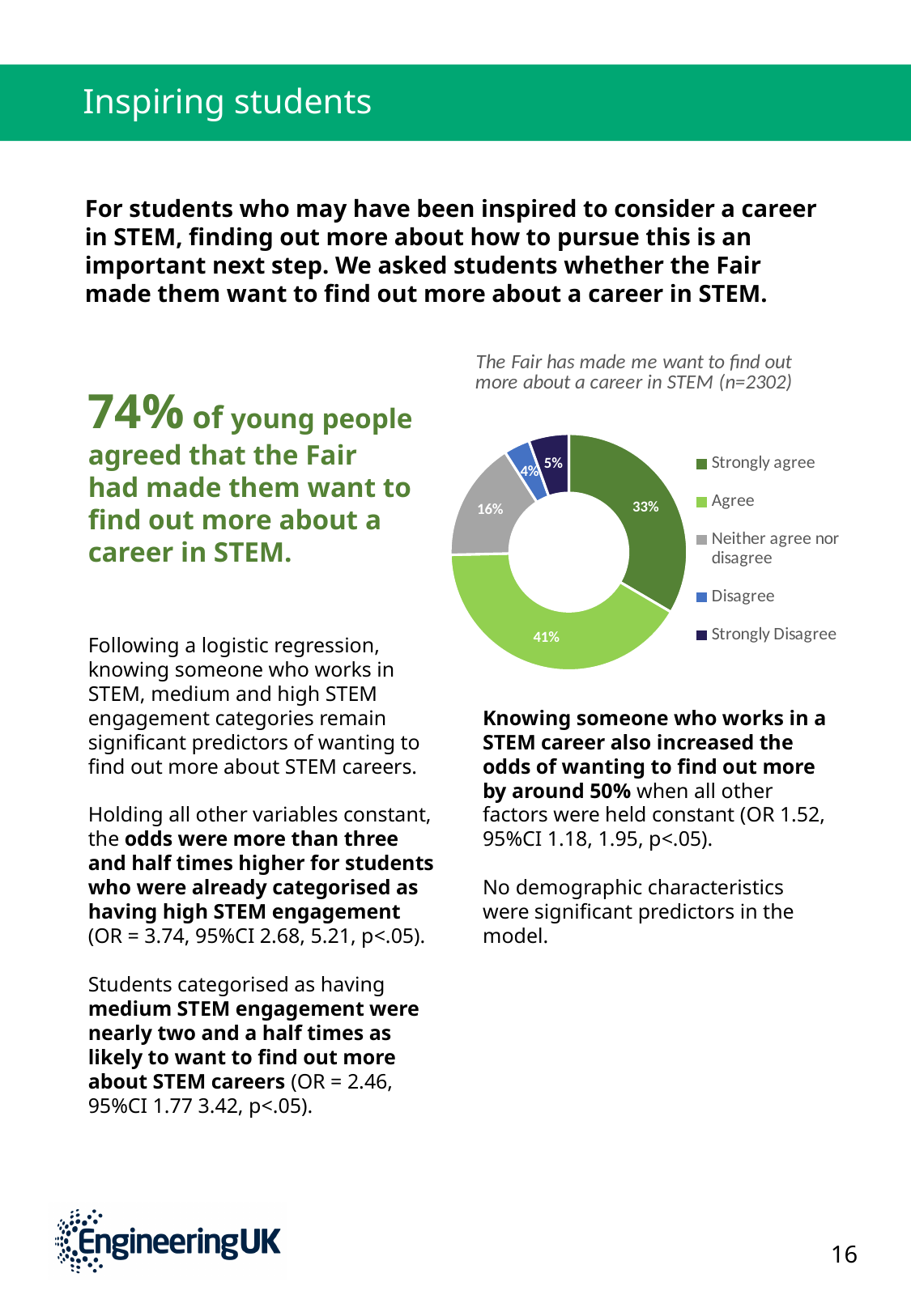
How many response categories does the legend list? 5 What is the sample size (n) given in the chart title? 2302 Which is larger, the share for 'Neither agree nor disagree' or the share for 'Strongly Disagree'? Neither agree nor disagree What percentage of respondents selected 'Strongly agree'? 33% What is the combined percentage for 'Strongly agree' and 'Agree'? 74% What kind of chart is shown on the slide? Pie chart (doughnut) What percentage of respondents selected 'Strongly Disagree'? 5% What percentage of respondents selected 'Agree'? 41% What percentage of respondents selected 'Neither agree nor disagree'? 16% Which response category has the largest share of the pie? Agree Which response category has the smallest share of the pie? Disagree What is the difference in percentage points between 'Agree' and 'Strongly agree'? 8